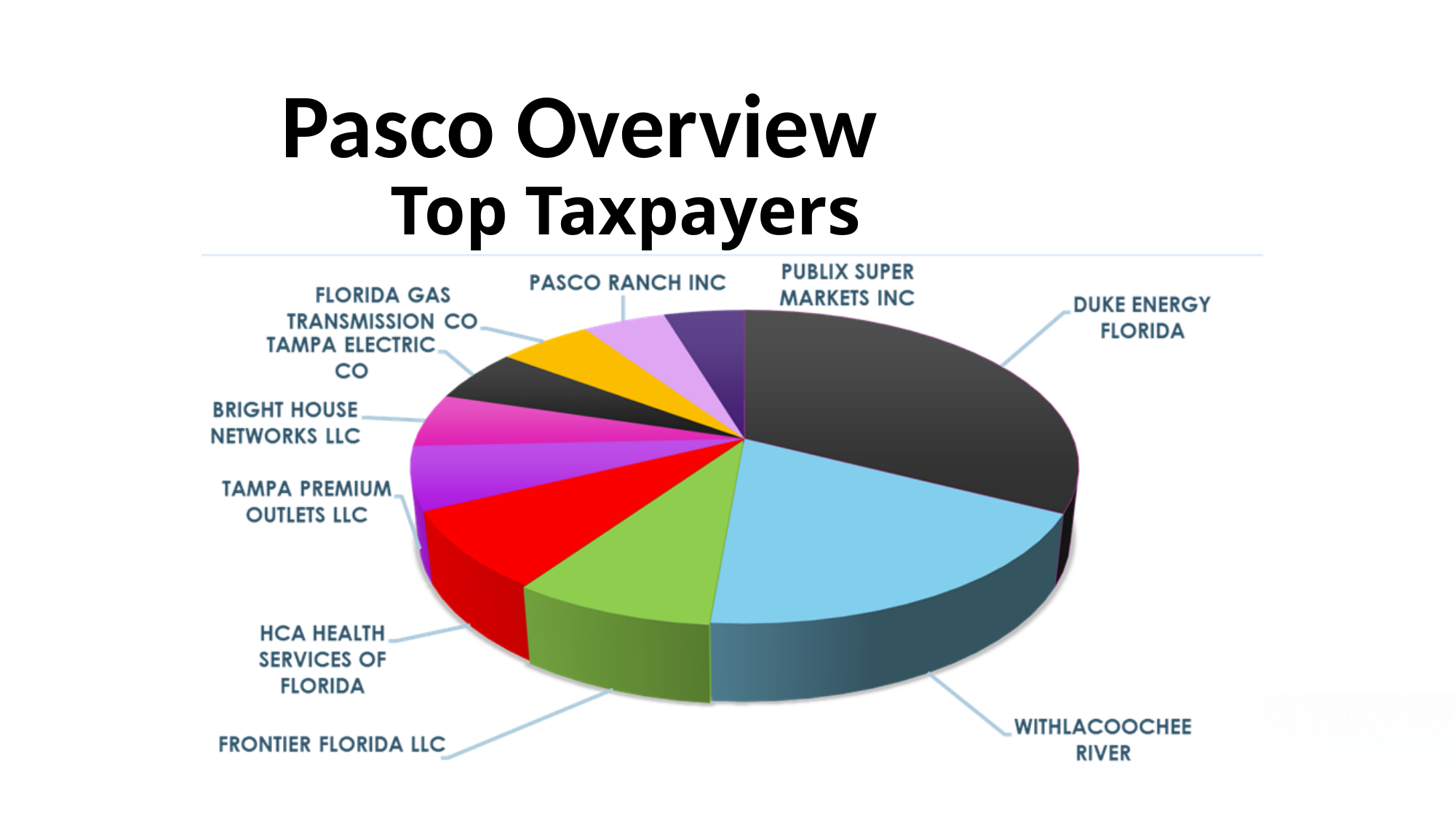
Which slice is larger, Duke Energy Florida or Withlacoochee River? Duke Energy Florida What kind of chart is shown on the slide? Pie chart Which slice is larger, Withlacoochee River or HCA Health Services of Florida? Withlacoochee River Which taxpayer has the largest slice of the pie chart? Duke Energy Florida What colour is the HCA Health Services of Florida slice? Red What is the title of the chart on the slide? Pasco Overview Top Taxpayers Which slice is larger, HCA Health Services of Florida or Tampa Electric Co? HCA Health Services of Florida How many taxpayers (slices) are shown in the pie chart? 10